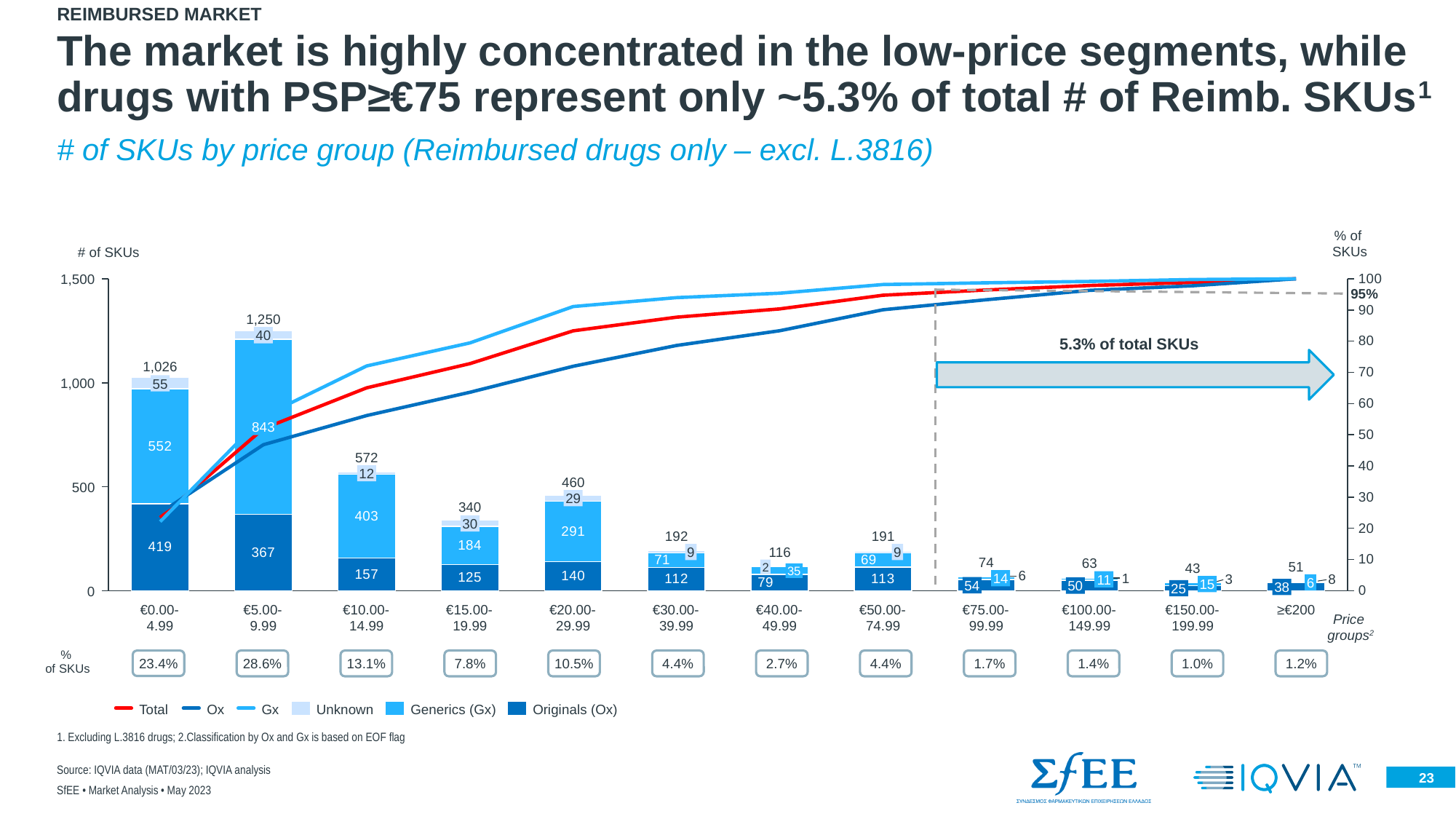
What is the total number of SKUs in the €5.00-9.99 price group? 1,250 Which price group has the highest total number of SKUs? €5.00-9.99 How many price groups are shown on the x axis? 12 What kind of chart is used to show the number of SKUs by price group? bar chart What is the total of the stacked bar for the €30.00-39.99 price group? 192 Which price group has more Generics (Gx) SKUs: €0.00-4.99 or €5.00-9.99? €5.00-9.99 What percentage of SKUs falls in the €20.00-29.99 price group? 10.5% How many entries does the legend list? 6 How many Originals (Ox) SKUs are in the €10.00-14.99 price group? 157 What is the difference between the total SKUs in the €5.00-9.99 group and the €0.00-4.99 group? 224 Which price group has the lowest total number of SKUs? €150.00-199.99 Do the cumulative Total, Ox and Gx lines rise or fall along the x axis? rise